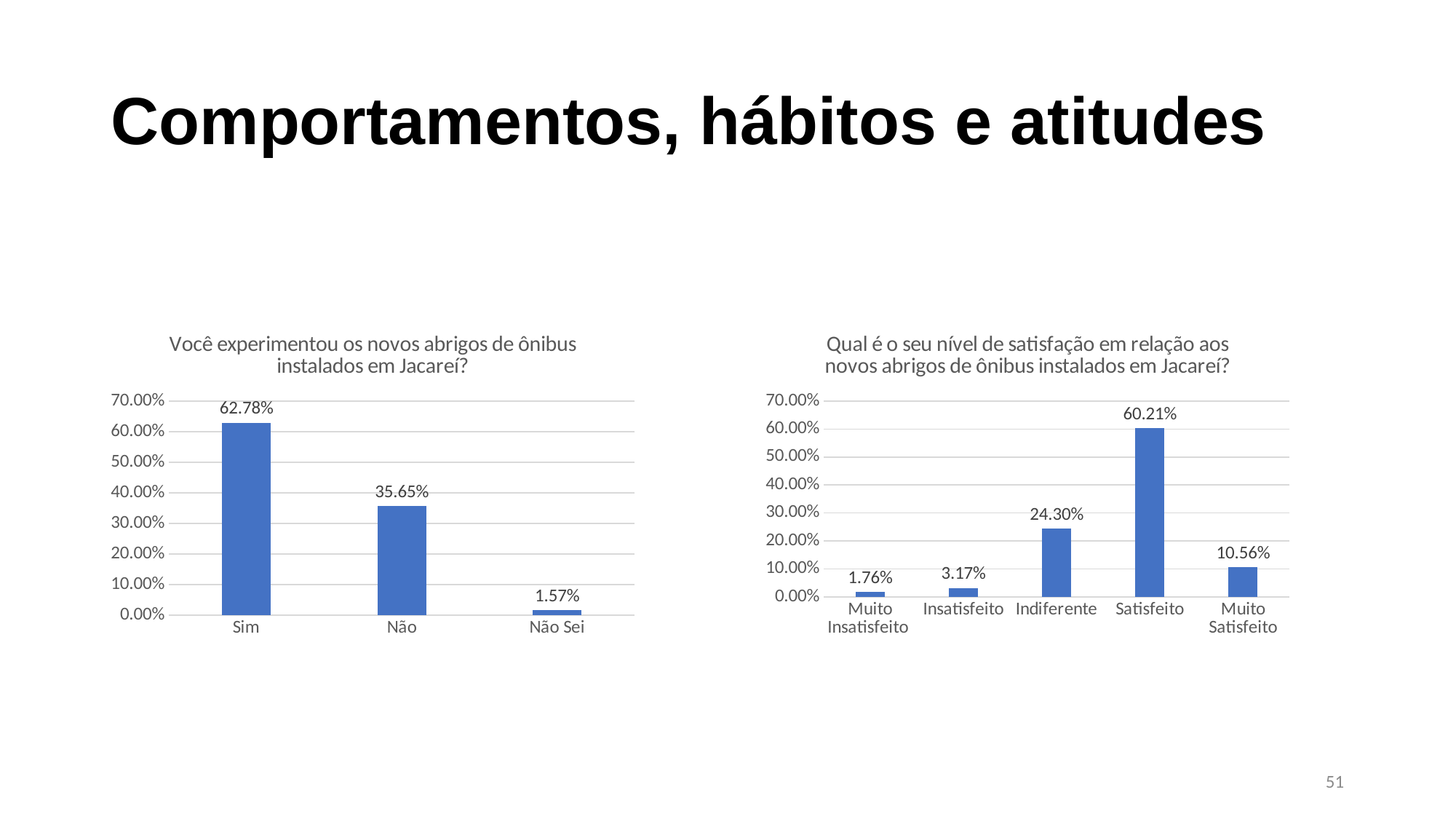
In the left chart ("Você experimentou os novos abrigos de ônibus instalados em Jacareí?"), what is the value for "Sim"? 62.78% In the right chart ("Qual é o seu nível de satisfação em relação aos novos abrigos de ônibus instalados em Jacareí?"), how many categories are shown? 5 In the left chart ("Você experimentou os novos abrigos de ônibus instalados em Jacareí?"), how many categories are shown? 3 In the right chart ("Qual é o seu nível de satisfação em relação aos novos abrigos de ônibus instalados em Jacareí?"), what is the value for "Satisfeito"? 60.21% In the left chart ("Você experimentou os novos abrigos de ônibus instalados em Jacareí?"), what is the value for "Não Sei"? 1.57% In the right chart ("Qual é o seu nível de satisfação em relação aos novos abrigos de ônibus instalados em Jacareí?"), what is the difference between the values for "Satisfeito" and "Indiferente"? 35.91% In the right chart ("Qual é o seu nível de satisfação em relação aos novos abrigos de ônibus instalados em Jacareí?"), which is larger, the value for "Muito Satisfeito" or the value for "Insatisfeito"? Muito Satisfeito In the left chart ("Você experimentou os novos abrigos de ônibus instalados em Jacareí?"), what is the difference between the values for "Sim" and "Não"? 27.13% In the right chart ("Qual é o seu nível de satisfação em relação aos novos abrigos de ônibus instalados em Jacareí?"), which category has the lowest value? Muito Insatisfeito In the left chart ("Você experimentou os novos abrigos de ônibus instalados em Jacareí?"), which category has the highest value? Sim In the right chart ("Qual é o seu nível de satisfação em relação aos novos abrigos de ônibus instalados em Jacareí?"), what is the value for "Indiferente"? 24.30% What kind of chart is the right chart ("Qual é o seu nível de satisfação em relação aos novos abrigos de ônibus instalados em Jacareí?")? Bar chart